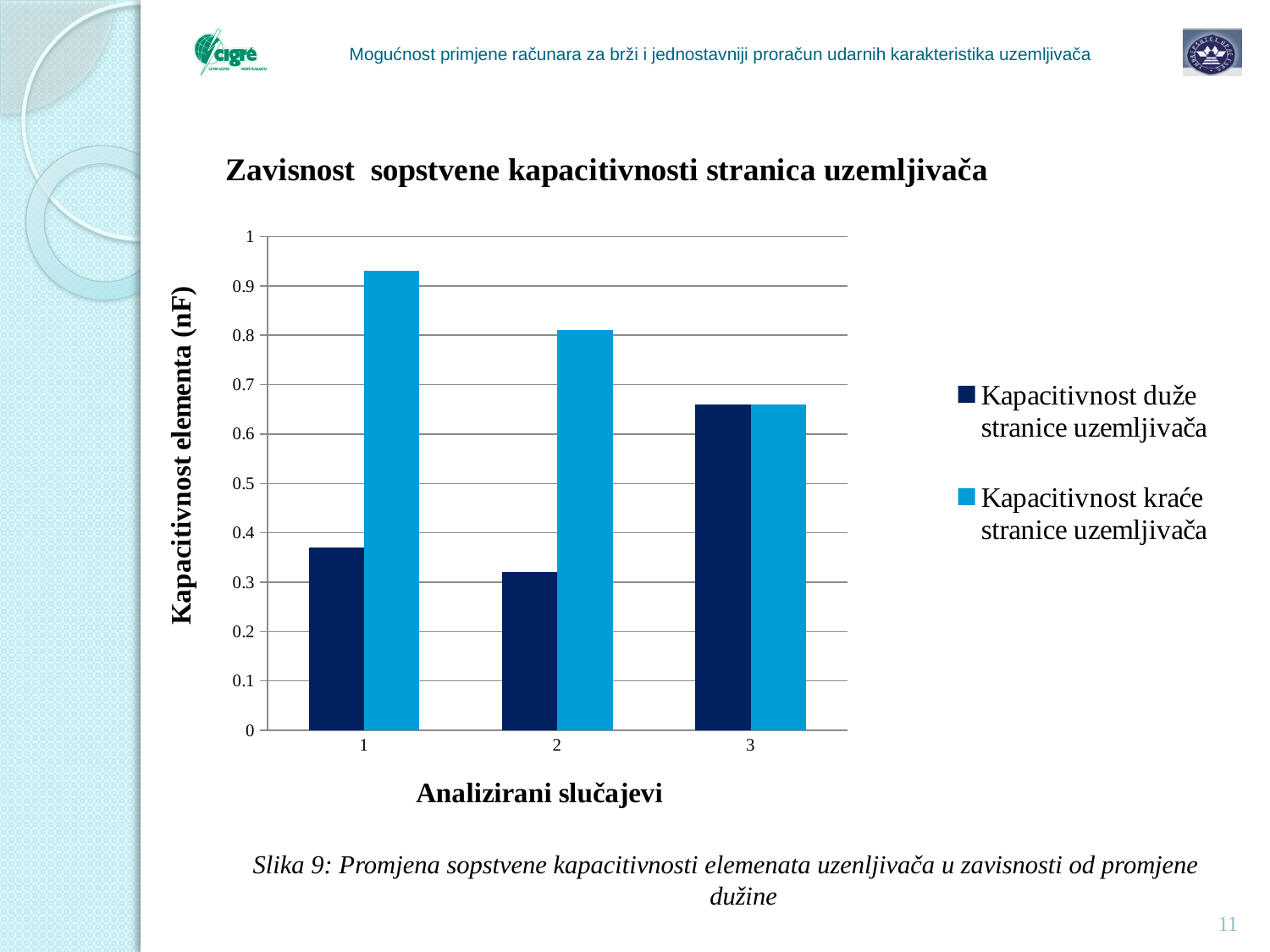
What is the label of the vertical axis? Kapacitivnost elementa (nF) In case 1, which series has the larger value: 'Kapacitivnost duže stranice uzemljivača' or 'Kapacitivnost kraće stranice uzemljivača'? Kapacitivnost kraće stranice uzemljivača Is the value of 'Kapacitivnost kraće stranice uzemljivača' for case 1 greater or less than 0.9? greater What kind of chart is shown on the slide? bar chart For which case is the value of 'Kapacitivnost kraće stranice uzemljivača' highest? 1 How many series does the legend list? 2 For which case is the value of 'Kapacitivnost duže stranice uzemljivača' highest? 3 For which case is the value of 'Kapacitivnost duže stranice uzemljivača' lowest? 2 What is the title of the chart? Zavisnost sopstvene kapacitivnosti stranica uzemljivača Does the value of 'Kapacitivnost kraće stranice uzemljivača' rise or fall from case 1 to case 3? fall How many analysed cases (categories) are shown on the x axis? 3 Is the value of 'Kapacitivnost duže stranice uzemljivača' for case 2 greater or less than 0.4? less